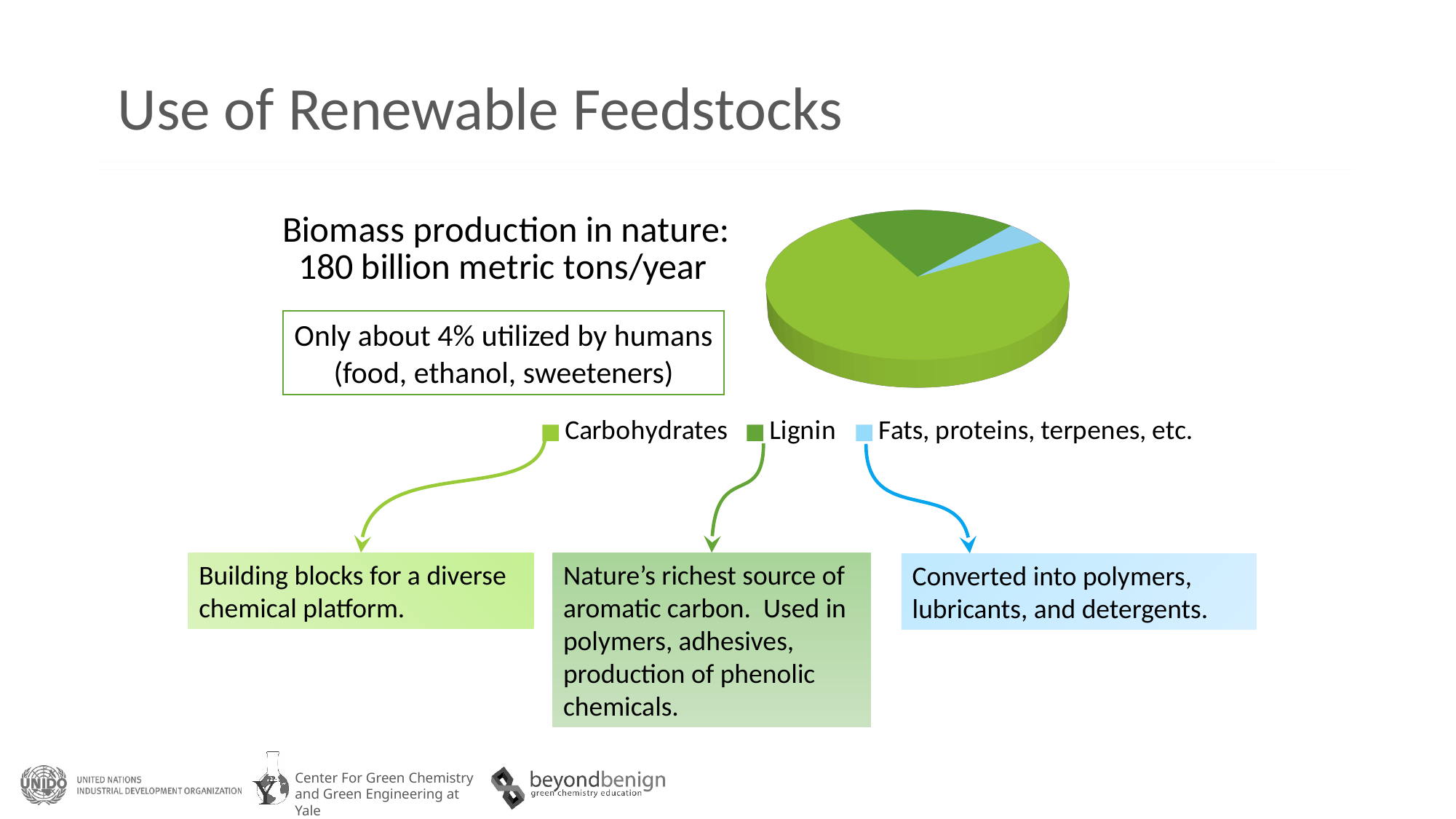
Which category has the smallest slice of the pie chart? Fats, proteins, terpenes, etc. How many slices does the pie chart have? 3 Does the Carbohydrates slice take up more or less than half of the pie chart? more How many entries does the pie chart's legend list? 3 What colour is the Lignin slice in the pie chart? dark green What kind of chart is shown on the slide? pie chart Which category has the largest slice of the pie chart? Carbohydrates Which slice is larger in the pie chart, Lignin or Fats, proteins, terpenes, etc.? Lignin Which slice is larger in the pie chart, Carbohydrates or Lignin? Carbohydrates What colour is the slice for Fats, proteins, terpenes, etc. in the pie chart? light blue